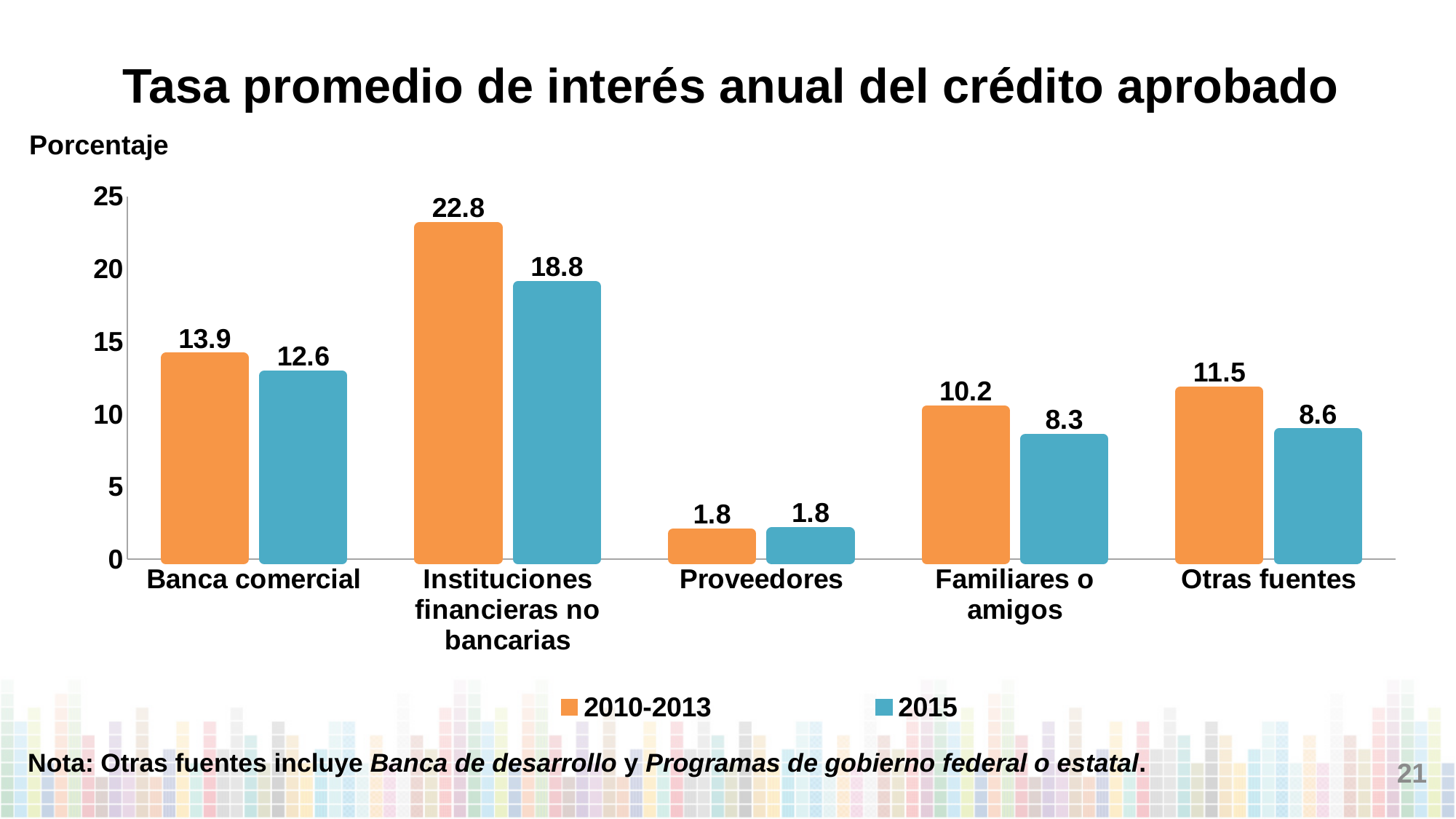
What is the difference between the 2010-2013 and 2015 values for Familiares o amigos? 1.9 What is the value for Otras fuentes in the 2015 series? 8.6 What is the title of the chart? Tasa promedio de interés anual del crédito aprobado Which category has the highest value in the 2010-2013 series? Instituciones financieras no bancarias Which is larger for Otras fuentes: the 2010-2013 value or the 2015 value? 2010-2013 How many series does the legend list? 2 How many categories are shown on the x axis? 5 What kind of chart is shown on the slide? Bar chart What is the difference between the 2010-2013 and 2015 values for Instituciones financieras no bancarias? 4.0 What is the value for Instituciones financieras no bancarias in the 2015 series? 18.8 What is the value for Banca comercial in the 2010-2013 series? 13.9 Which category has the lowest value in the 2015 series? Proveedores